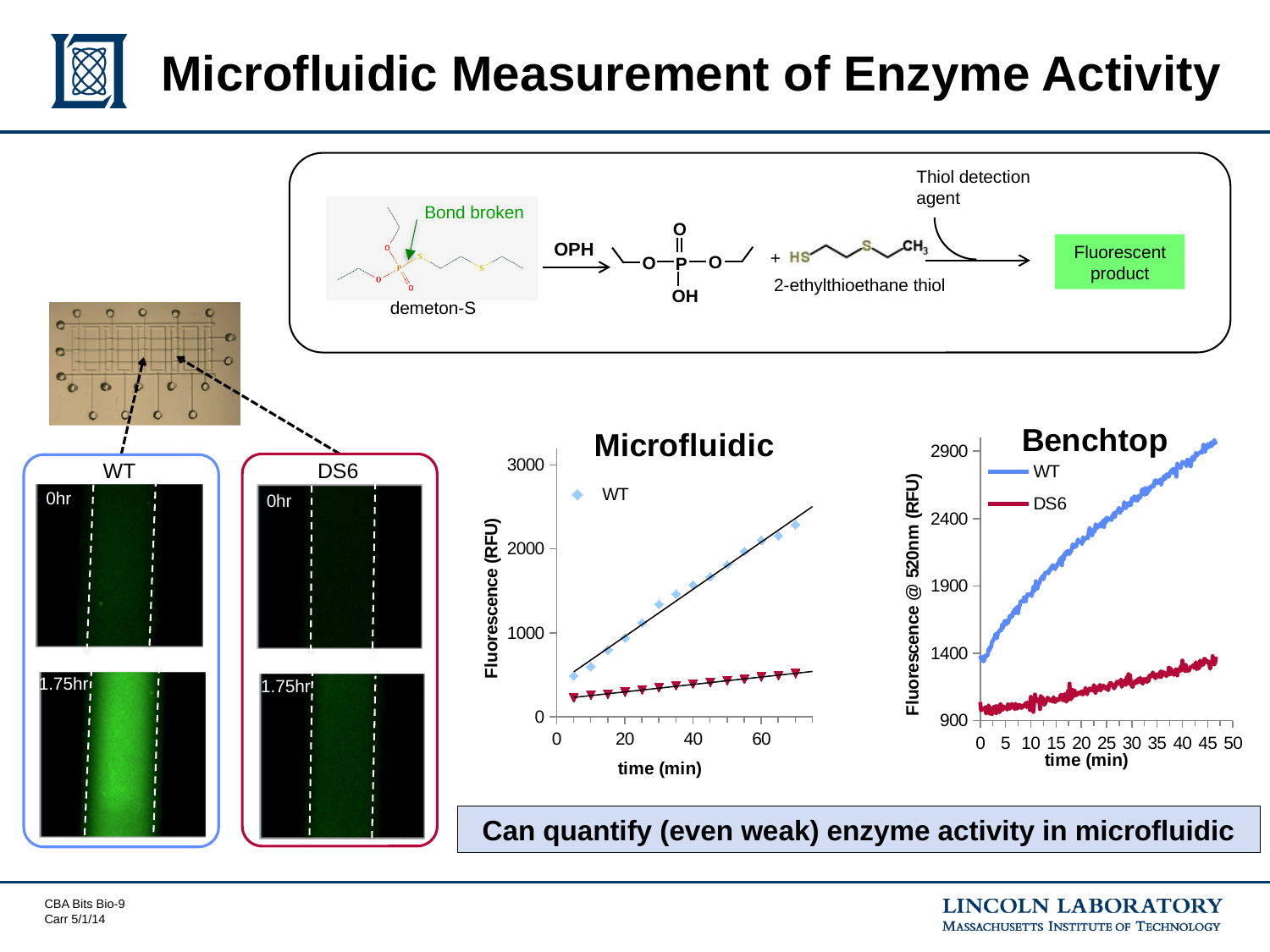
In the Microfluidic chart, does the WT fluorescence rise or fall as time increases? rise In the Benchtop chart, is the WT value at 45 min greater or less than 2400? greater In the Benchtop chart, does the DS6 fluorescence rise or fall over time? rise What is the y-axis title of the Benchtop chart? Fluorescence @ 520nm (RFU) In the Benchtop chart, which series has the larger value at 40 min, WT or DS6? WT What kind of chart is the Benchtop chart? line chart In the Benchtop chart, which series is plotted in blue? WT What kind of chart is the Microfluidic chart? scatter chart In the Benchtop chart, is the DS6 value at 20 min greater or less than 1400? less How many series does the legend of the Benchtop chart list? 2 In the Microfluidic chart, is the WT value at 60 min greater or less than 2000? greater